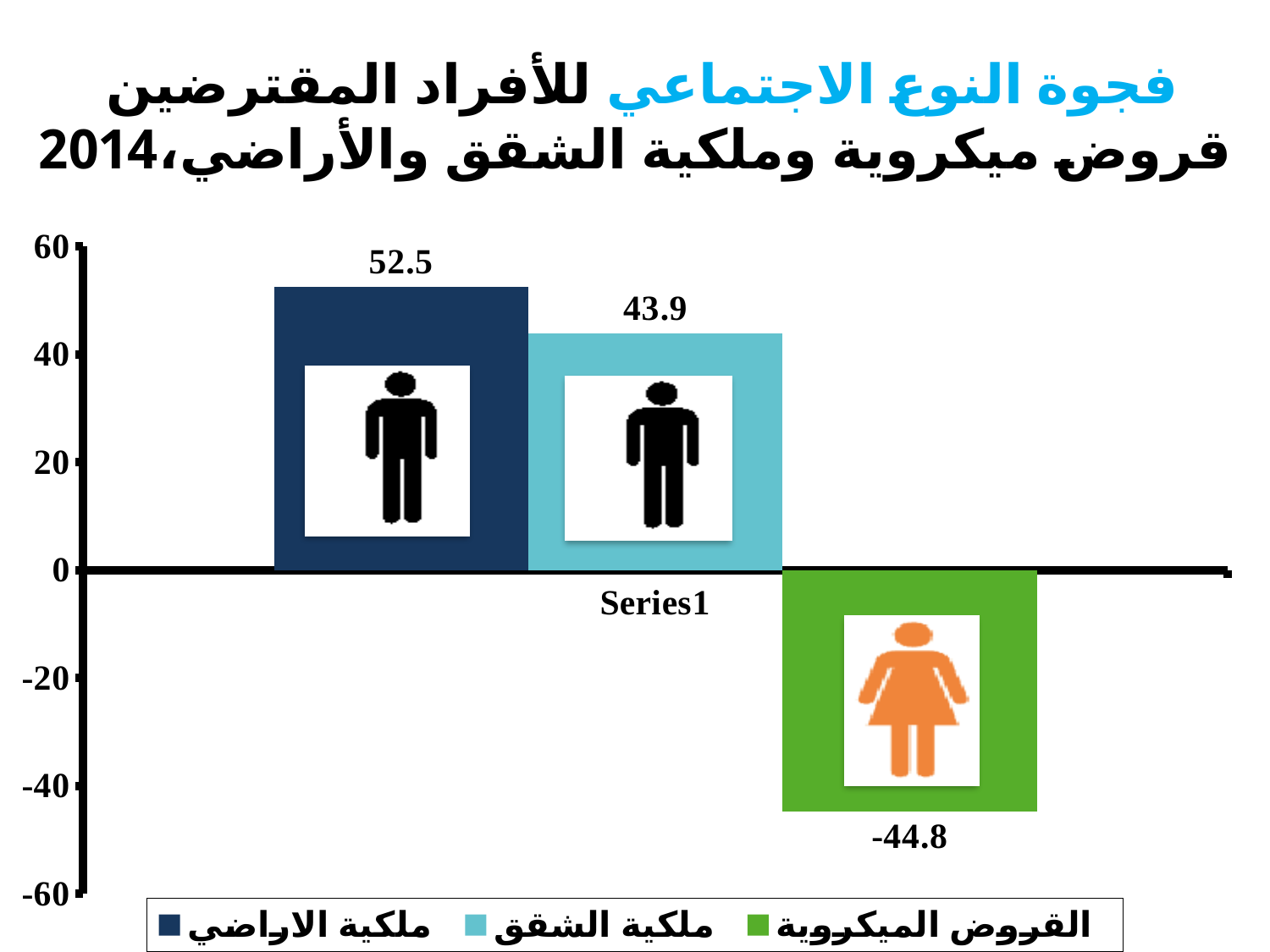
What is the value for ملكية الشقق (apartment ownership)? 43.9 Which series has the highest value? ملكية الاراضي What kind of chart is shown on the slide? bar chart Which is larger, the value for ملكية الاراضي or the value for ملكية الشقق? ملكية الاراضي What is the value for ملكية الاراضي (land ownership)? 52.5 What colour is the bar for القروض الميكروية? green Which series has the lowest value? القروض الميكروية Is the value for القروض الميكروية greater or less than 0? less What is the difference between the values for ملكية الاراضي and ملكية الشقق? 8.6 What is the value for القروض الميكروية (microloans)? -44.8 How many series does the legend list? 3 Is the value for ملكية الشقق greater or less than 40? greater